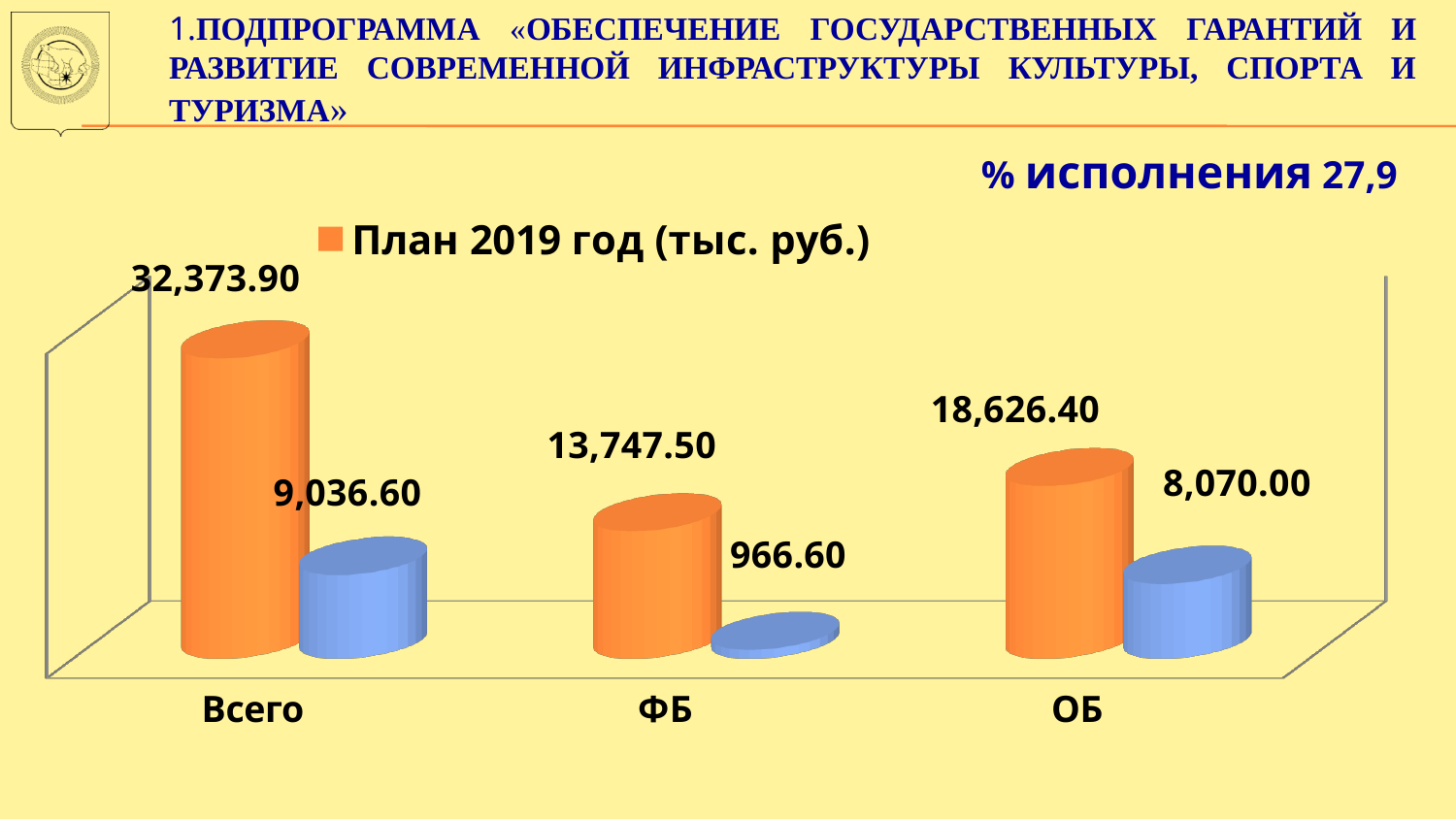
What is the value of План 2019 год (тыс. руб.) for ОБ? 18,626.40 What kind of chart is shown on the slide? Bar chart How many categories are shown on the x axis? 3 What is the value of План 2019 год (тыс. руб.) for Всего? 32,373.90 What is the value of План 2019 год (тыс. руб.) for ФБ? 13,747.50 Which category has the lowest value on the blue bars? ФБ What is the value shown on the blue bar for ОБ? 8,070.00 Which has the larger План 2019 год value, ФБ or ОБ? ОБ What is the difference between the План 2019 год values for ОБ and ФБ? 4,878.90 What is the difference between the blue bar values for Всего and ОБ? 966.60 What is the value shown on the blue bar for ФБ? 966.60 Which category has the highest value for План 2019 год (тыс. руб.)? Всего